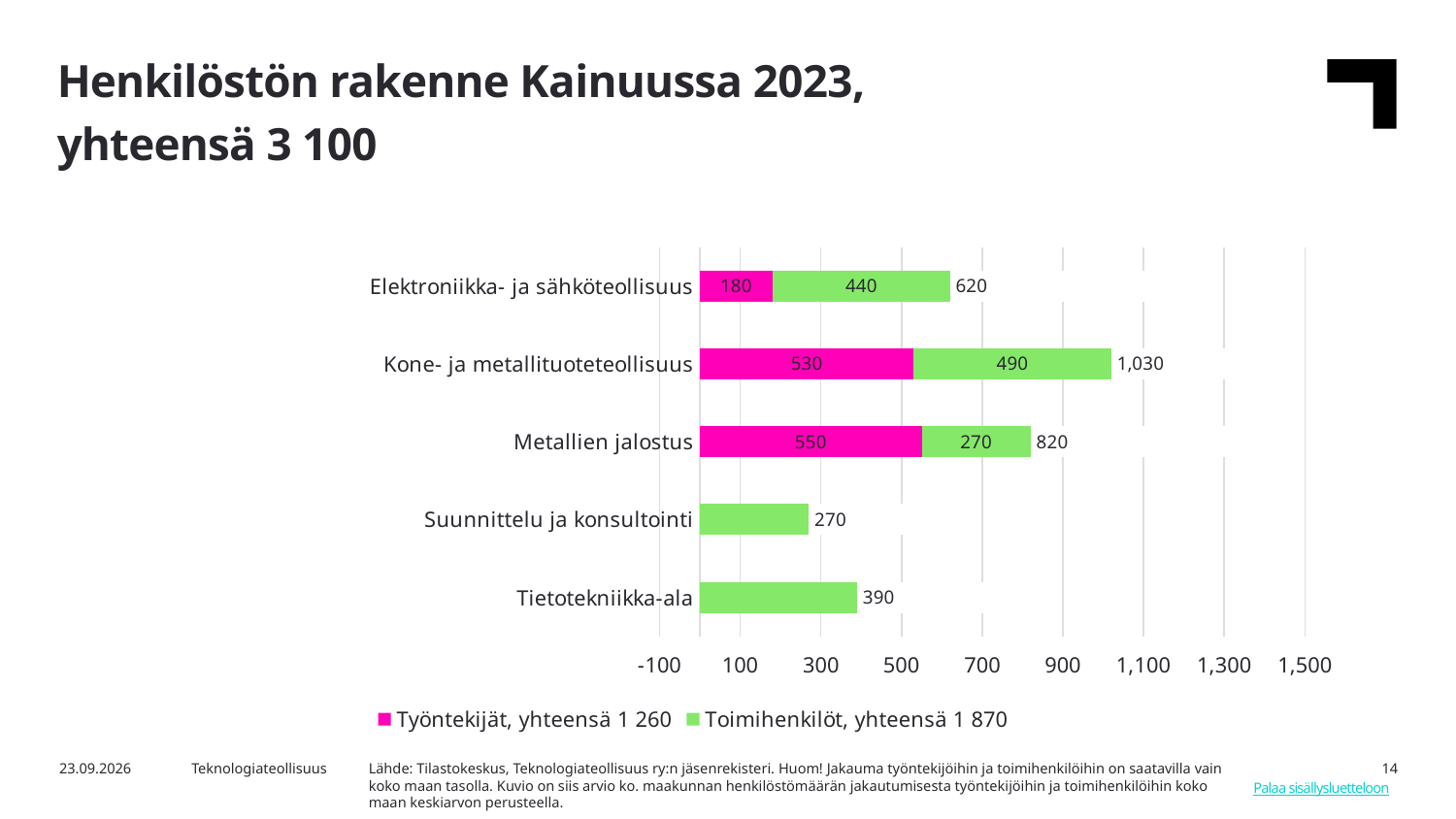
What is the title of the chart on the slide? Henkilöstön rakenne Kainuussa 2023, yhteensä 3 100 What kind of chart is shown on the slide? Stacked bar chart How many categories are shown on the chart? 5 What is the Toimihenkilöt value for Elektroniikka- ja sähköteollisuus? 440 Which category has the highest total? Kone- ja metallituoteteollisuus Which is larger: the Työntekijät value for Metallien jalostus or for Kone- ja metallituoteteollisuus? Metallien jalostus What is the total for Tietotekniikka-ala? 390 How many series does the legend list? 2 What is the total for the Metallien jalostus bar? 820 What is the difference between the totals of Kone- ja metallituoteteollisuus and Elektroniikka- ja sähköteollisuus? 410 Which category has the lowest total? Suunnittelu ja konsultointi What is the Työntekijät value for Kone- ja metallituoteteollisuus? 530